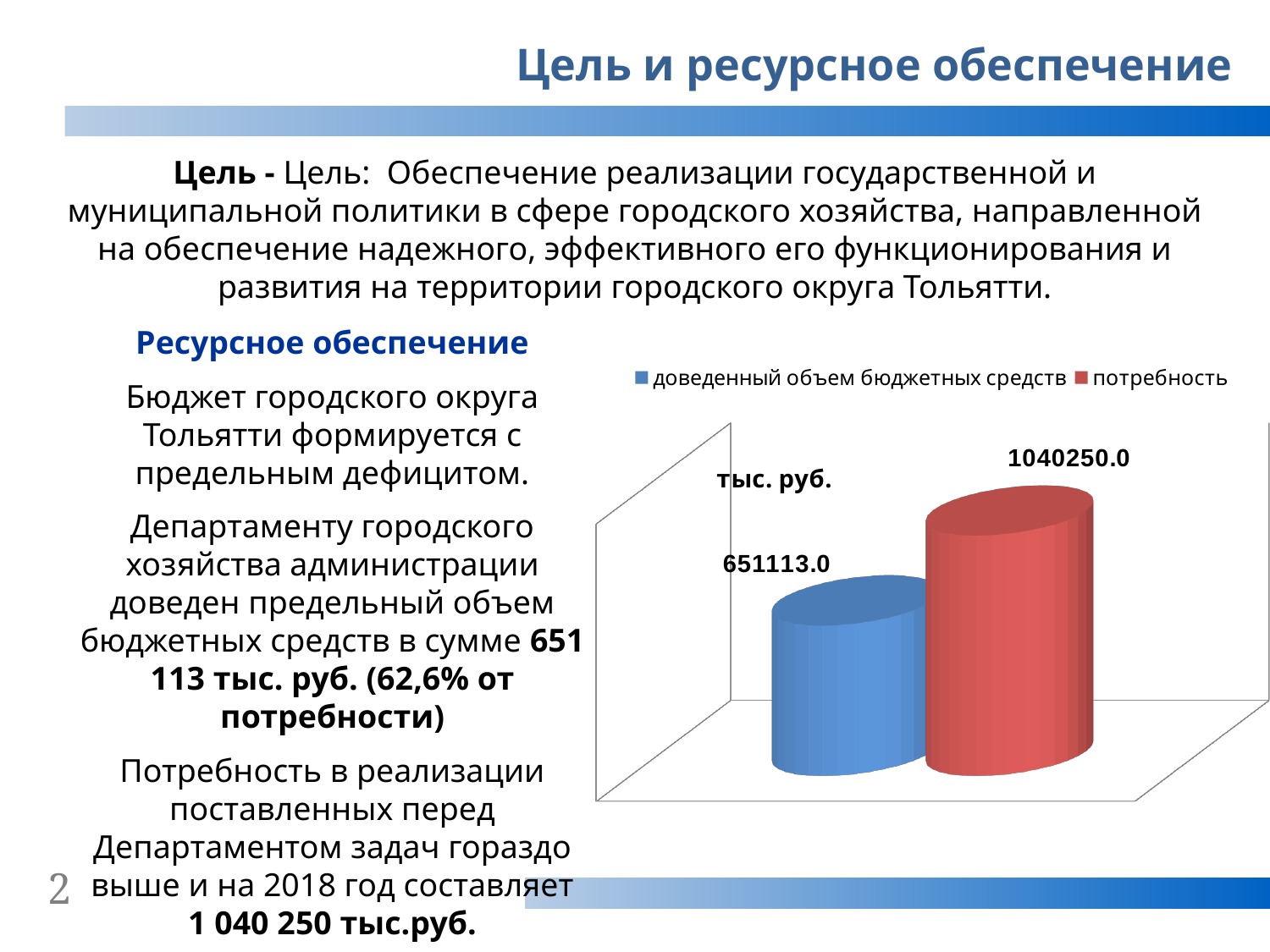
How many series does the chart legend list? 2 What unit label is printed on the chart? тыс. руб. Which series has the higher value, "доведенный объем бюджетных средств" or "потребность"? потребность What kind of chart is shown on the slide? bar chart What colour is the bar for "потребность"? red Which series has the lowest value on the chart? доведенный объем бюджетных средств What is the value shown for the series "потребность"? 1040250.0 How many bars are plotted on the chart? 2 Which series has the highest value on the chart? потребность What is the difference between the value for "потребность" and the value for "доведенный объем бюджетных средств"? 389137.0 What is the value shown for the series "доведенный объем бюджетных средств"? 651113.0